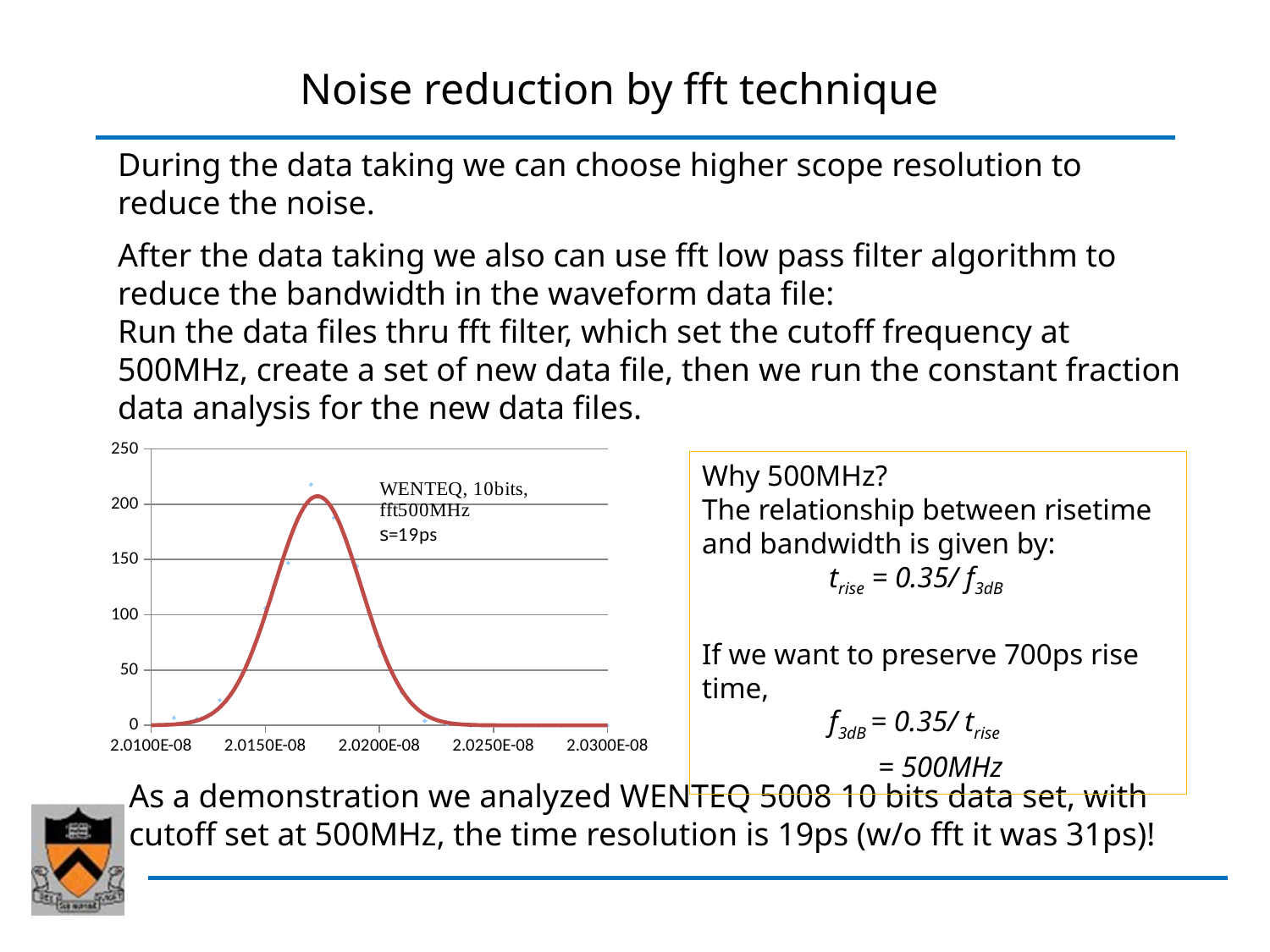
Is the peak value of the fitted curve greater or less than 200? greater Is the value of the curve at 2.0200E-08 greater or less than 100? less Is the value of the curve at 2.0200E-08 greater or less than 50? greater What is the highest value shown on the y axis? 250 Between which two x-axis ticks does the peak of the curve lie? 2.0150E-08 and 2.0200E-08 How do the values change along the x axis from 2.0100E-08 to 2.0300E-08? They rise to a peak and then fall What kind of chart is shown on the slide? A scatter plot with a fitted curve What time resolution (s) is stated in the chart annotation? s=19ps